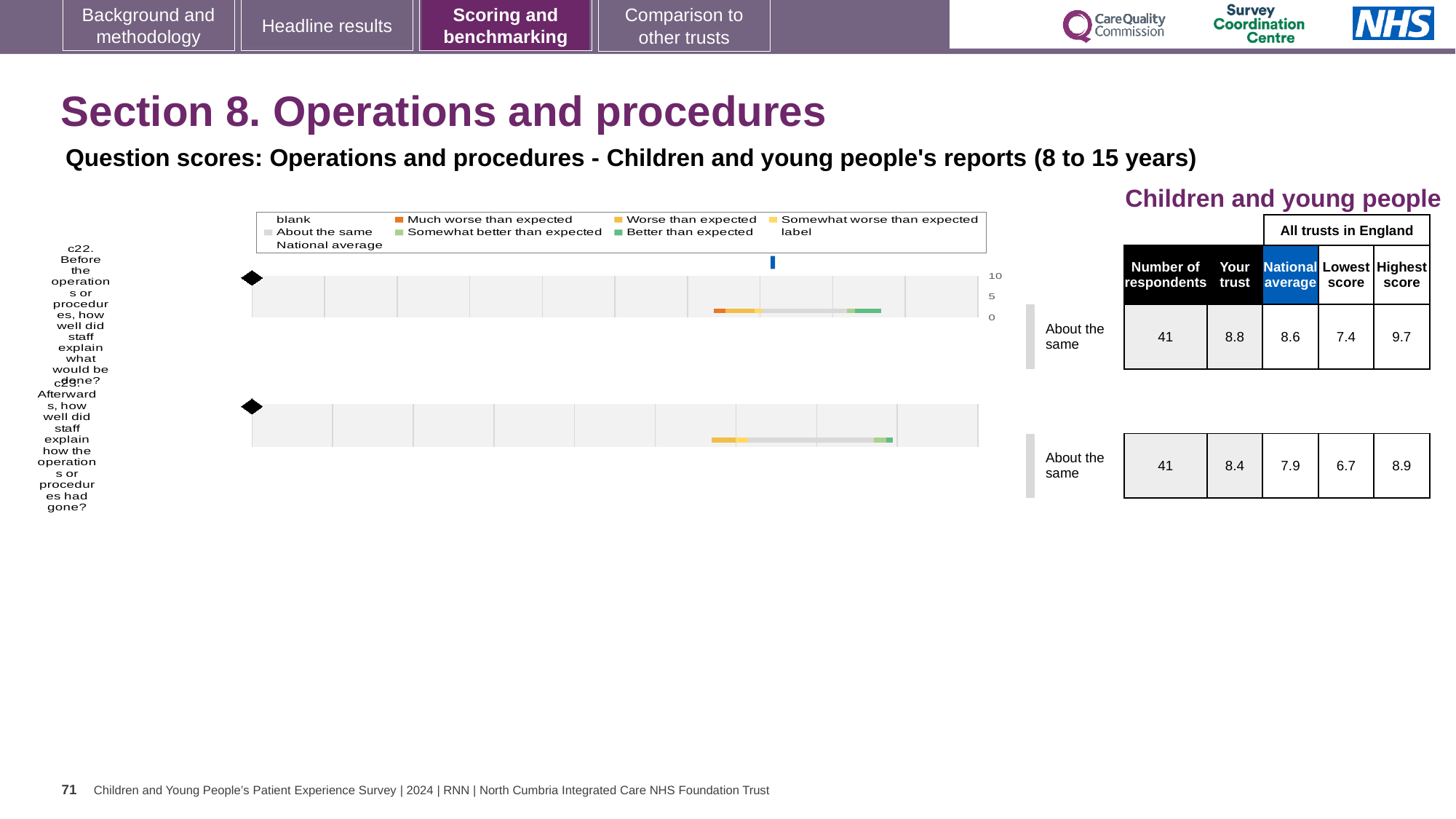
How many questions (rows) are plotted in the chart? 2 Which legend entry is represented by the orange colour in the chart? Much worse than expected What kind of chart is used to show the question scores for c22 and c23? bar chart What benchmark category is shown for c23 next to the chart? About the same How many respondents answered c22 according to the table beside the chart? 41 What is the National average score for c22 shown in the table beside the chart? 8.6 Which question has the higher 'Your trust' score, c22 or c23? c22 What is the difference between the Highest score and the Lowest score for c22 in the table beside the chart? 2.3 What is the Highest score for c23 shown in the table beside the chart? 8.9 What is the difference between the 'Your trust' score and the National average for c23 in the table beside the chart? 0.5 What is the 'Your trust' score for c23 (Afterwards, how well did staff explain how the operations or procedures had gone?) in the table beside the chart? 8.4 What is the 'Your trust' score for c22 (Before the operations or procedures, how well did staff explain what would be done?) in the table beside the chart? 8.8